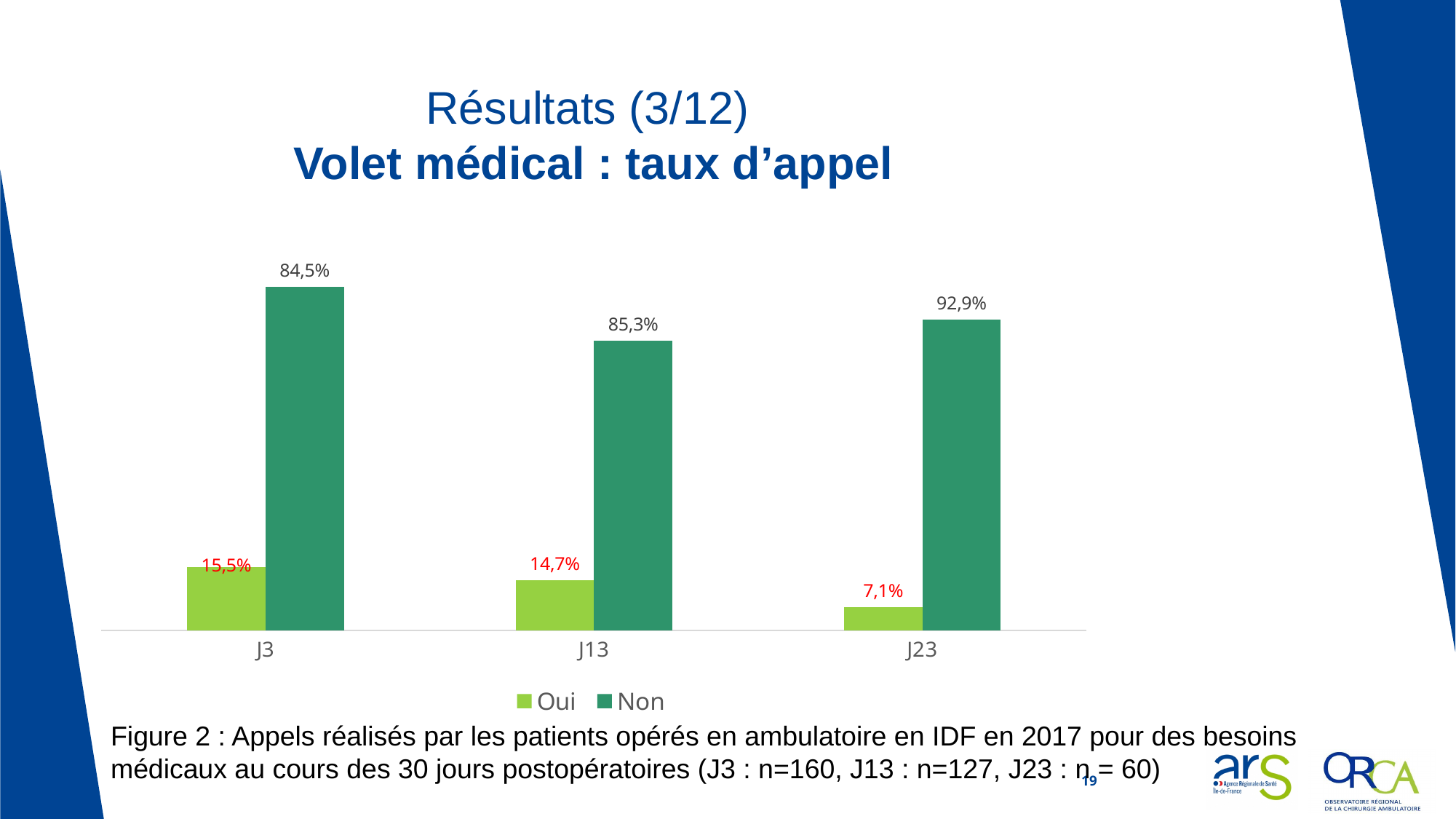
What kind of chart is shown on the slide? Bar chart What is the value of the Non series for J23? 92,9% Do the Oui values rise or fall from J3 to J23? Fall Which category has the highest value for the Non series? J23 Which is larger: the Non value for J3 or the Non value for J23? J23 What is the value of the Oui series for J23? 7,1% How many categories are shown on the x axis? 3 What is the value of the Non series for J13? 85,3% Which category has the lowest value for the Oui series? J23 What is the difference between the Oui values for J3 and J23? 8,4% What is the value of the Oui series for J3? 15,5% How many series does the legend list? 2